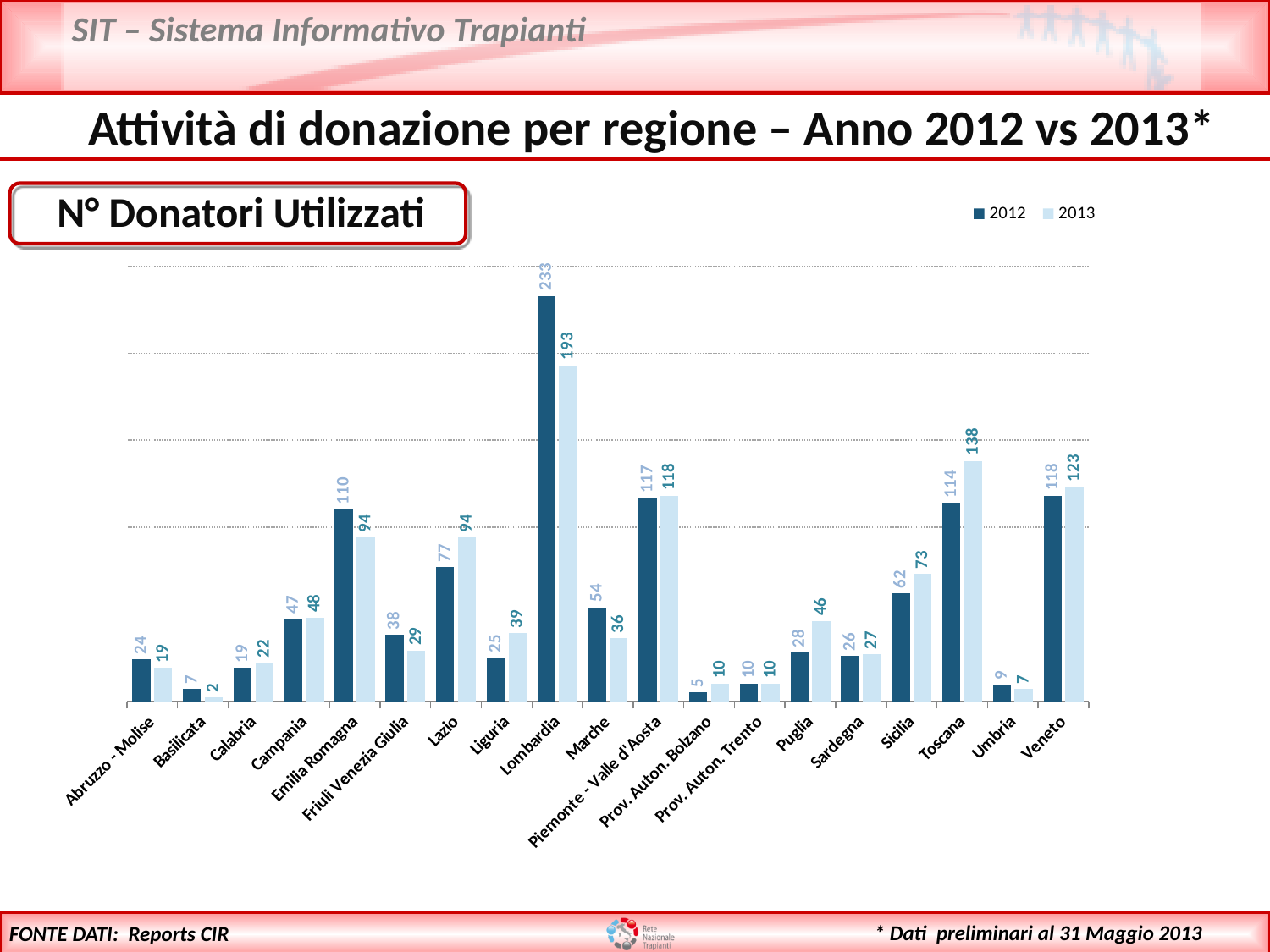
What is the 2013 value for Toscana? 138 What is the number of donors used (N° Donatori Utilizzati) in Lombardia in 2012? 233 Which two years are compared in the legend? 2012 and 2013 What is the 2012 value for Lazio? 77 How many series does the legend list? 2 Which region has the lowest value in 2013? Basilicata How many regions are shown on the x axis? 19 What is the difference between the 2012 and 2013 values for Lombardia? 40 What kind of chart is shown on the slide? Bar chart What is the difference between the 2013 and 2012 values for Puglia? 18 Which is larger for Emilia Romagna, the 2012 value or the 2013 value? 2012 Which region has the highest value in 2013? Lombardia